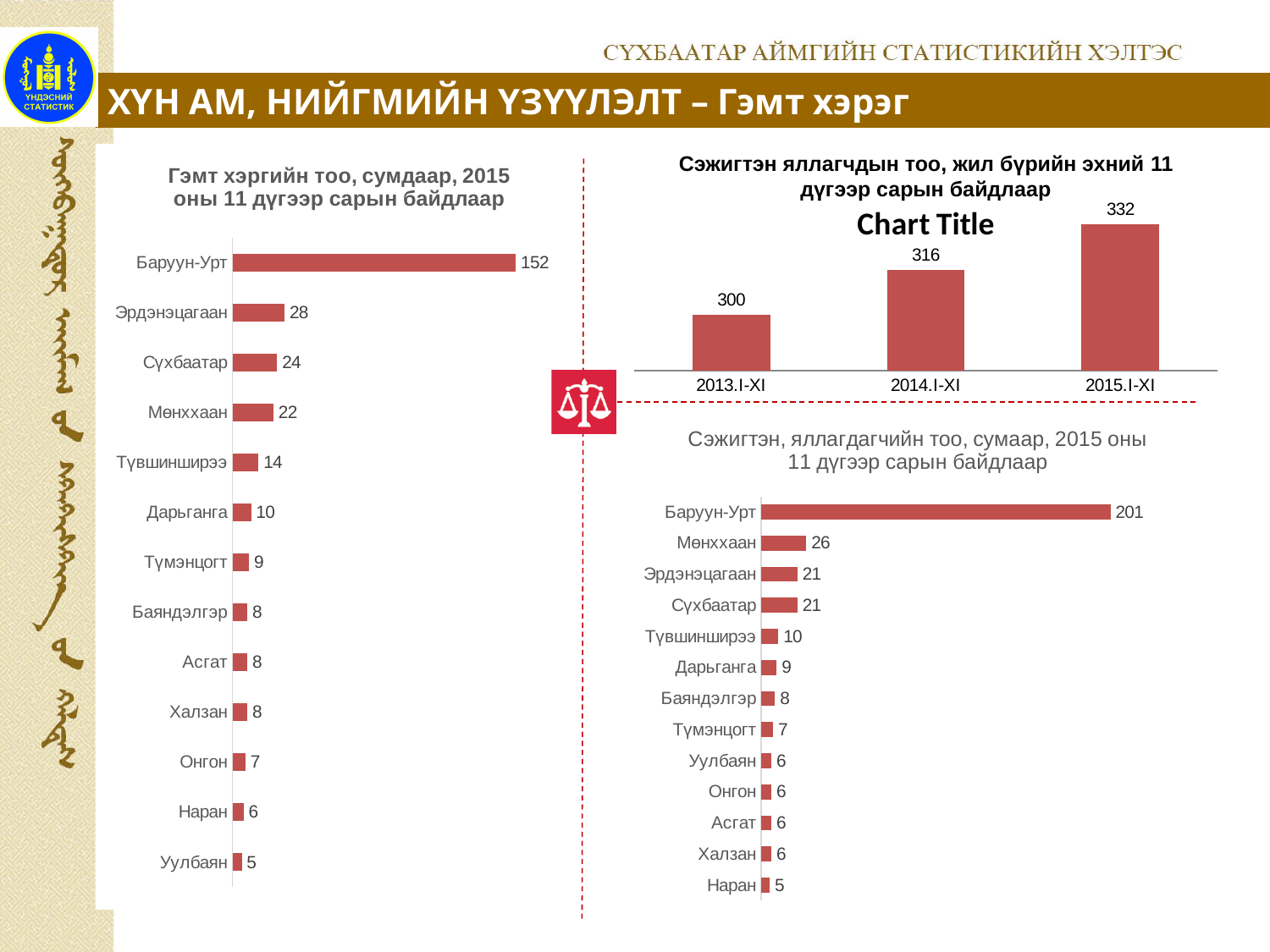
What kind of chart is the top-right chart (Сэжигтэн яллагчдын тоо)? bar chart In the bottom-right chart (Сэжигтэн, яллагдагчийн тоо, сумаар), what is the value for Наран? 5 In the left chart (Гэмт хэргийн тоо, сумдаар), which is larger, Мөнххаан or Түвшинширээ? Мөнххаан In the bottom-right chart (Сэжигтэн, яллагдагчийн тоо, сумаар), which category has the highest value? Баруун-Урт In the top-right chart (Сэжигтэн яллагчдын тоо, жил бүрийн эхний 11 дүгээр сарын байдлаар), what is the value for 2014.I-XI? 316 In the top-right chart (Сэжигтэн яллагчдын тоо), do the values rise or fall from 2013.I-XI to 2015.I-XI? rise In the bottom-right chart (Сэжигтэн, яллагдагчийн тоо, сумаар), what is the value for Мөнххаан? 26 In the top-right chart (Сэжигтэн яллагчдын тоо), what is the difference between 2015.I-XI and 2013.I-XI? 32 In the left chart (Гэмт хэргийн тоо, сумдаар), what is the difference between Эрдэнэцагаан and Сүхбаатар? 4 In the left chart (Гэмт хэргийн тоо, сумдаар), how many categories are shown? 13 In the left chart (Гэмт хэргийн тоо, сумдаар), what is the value for Баруун-Урт? 152 In the left chart (Гэмт хэргийн тоо, сумдаар), which category has the lowest value? Уулбаян